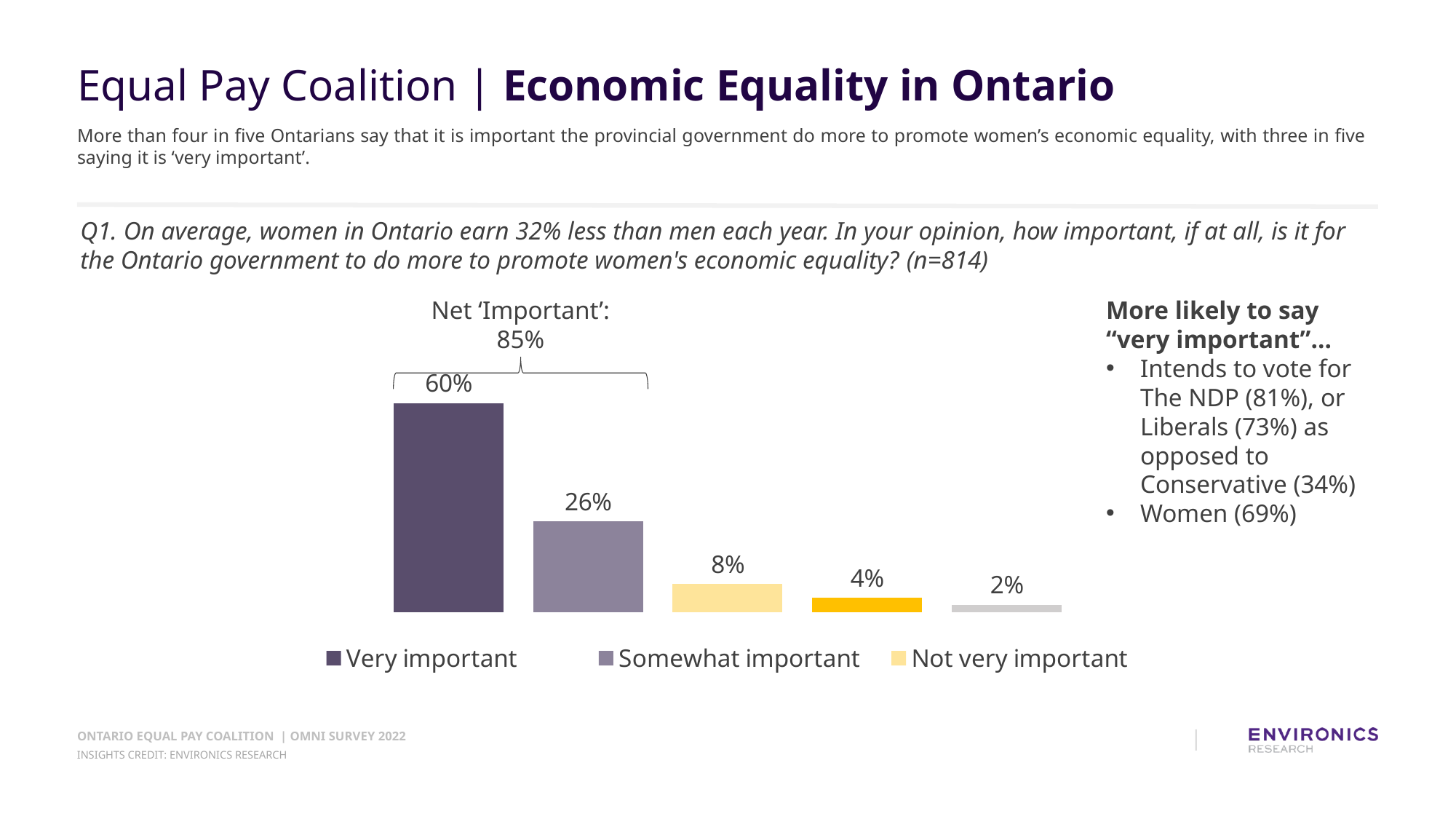
Which response category has the highest percentage? Very important What percentage of respondents said 'Not very important'? 8% What is the Net 'Important' figure shown above the chart? 85% What is the difference in percentage points between 'Very important' and 'Somewhat important'? 34 How many bars are plotted in the chart? 5 What type of chart is shown on the slide? Bar chart What percentage of respondents said it is 'Very important' for the Ontario government to do more to promote women's economic equality? 60% How many entries does the chart legend list? 3 Which is larger, the share saying 'Somewhat important' or the share saying 'Not very important'? Somewhat important What is the value shown on the smallest bar in the chart? 2% Do the bar values rise or fall from left to right across the chart? Fall What percentage of respondents said 'Somewhat important'? 26%